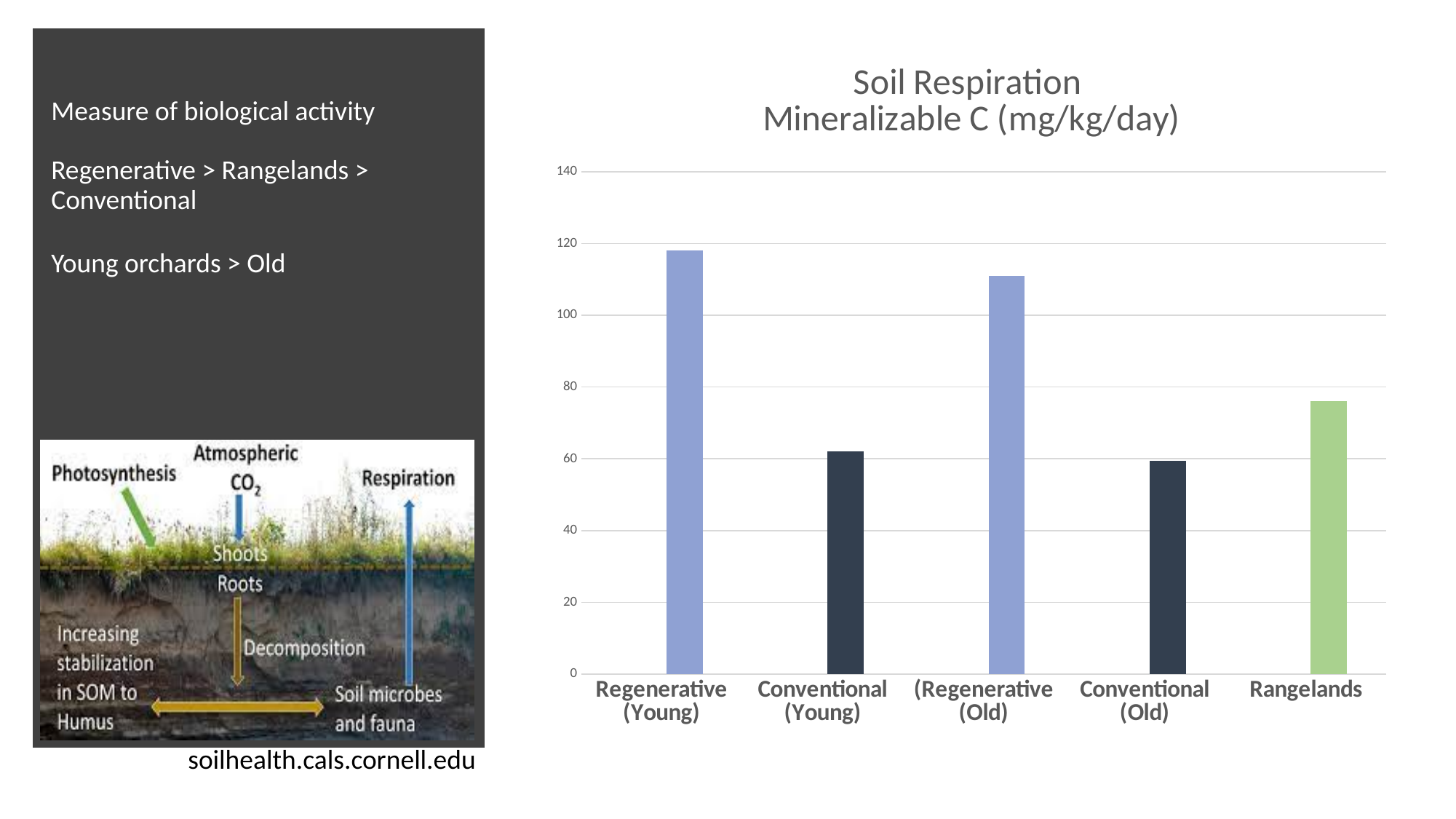
Is the value for Conventional (Old) greater or less than 40? greater Is the value for Rangelands greater or less than 60? greater How many categories are plotted on the chart? 5 Which category has the highest soil respiration value? Regenerative (Young) Which is larger, the value for Regenerative (Young) or the value for Regenerative (Old)? Regenerative (Young) What unit is given in the chart title for mineralizable C? mg/kg/day Is the value for Regenerative (Young) greater or less than 100? greater Which is larger, the value for Regenerative (Young) or the value for Conventional (Young)? Regenerative (Young) Which category has the lowest soil respiration value? Conventional (Old) Which is larger, the value for Rangelands or the value for Conventional (Old)? Rangelands What kind of chart is shown on the slide? bar chart